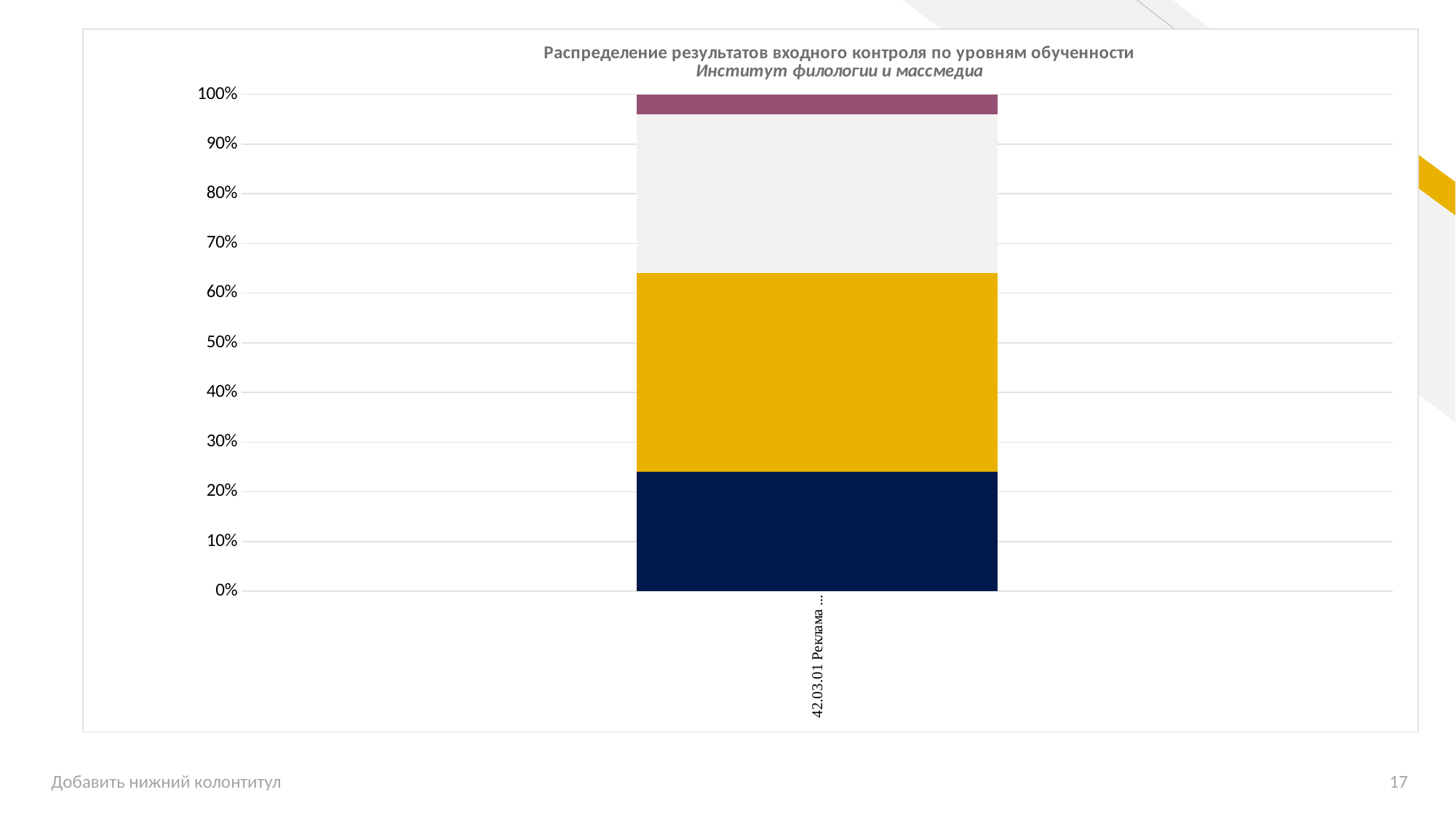
What is the title of the chart? Распределение результатов входного контроля по уровням обученности How many categories are plotted on the x axis of the chart? 1 Which is larger: the yellow segment or the dark navy segment of the bar? The yellow segment Is the top of the yellow segment of the bar greater or less than 60%? greater Which coloured segment of the stacked bar is the smallest? The purple (top) segment Which institute is named in the chart's subtitle? Институт филологии и массмедиа Is the top of the light grey segment of the bar greater or less than 90%? greater What is the total height of the stacked bar for 42.03.01 Реклама ...? 100% What kind of chart is shown on the slide? Stacked bar chart Is the top of the dark navy (bottom) segment of the bar greater or less than 30%? less Which coloured segment of the stacked bar is the largest? The yellow segment What is the highest value shown on the vertical axis? 100%